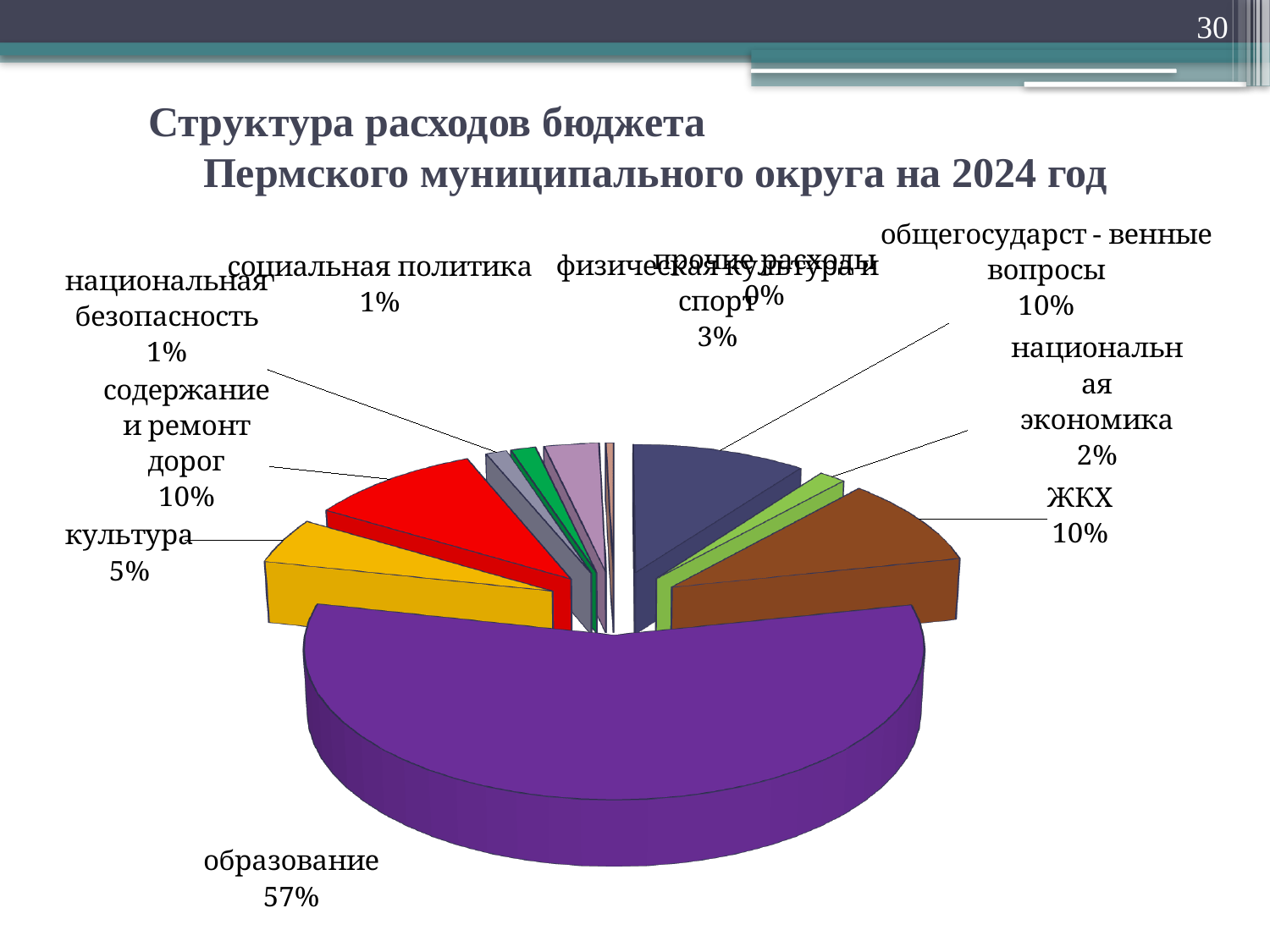
What share of the budget expenditure goes to культура? 5% What share of the budget expenditure goes to физическая культура и спорт? 3% Which category has the largest share of the budget expenditure? образование What share of the budget expenditure goes to содержание и ремонт дорог? 10% Which category has the smallest share of the budget expenditure? прочие расходы What is the difference in percentage points between the shares for образование and ЖКХ? 47 What share of the budget expenditure goes to национальная экономика? 2% What share of the budget expenditure goes to образование? 57% What kind of chart is shown on the slide? pie chart Which has a larger share: культура or национальная экономика? культура How many categories are shown in the pie chart? 10 What share of the budget expenditure goes to ЖКХ? 10%